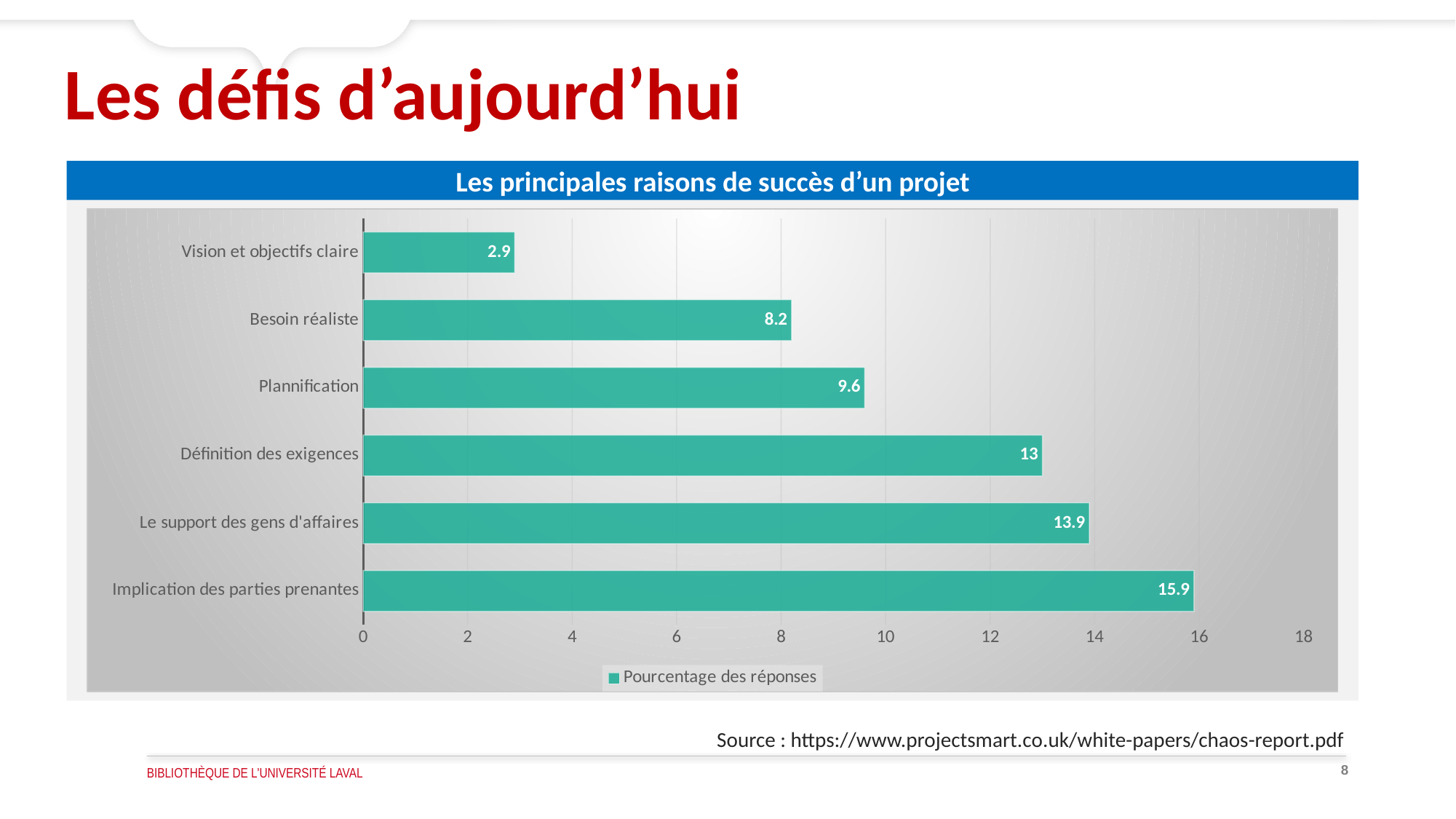
What kind of chart is shown on the slide? bar chart What is the title of the chart? Les principales raisons de succès d'un projet How many series does the legend list? 1 Which category has the highest value? Implication des parties prenantes What is the value for Implication des parties prenantes? 15.9 How many categories are shown in the chart? 6 What is the difference between the values for Le support des gens d'affaires and Définition des exigences? 0.9 Is the value for Définition des exigences greater or less than 12? greater What is the value for Vision et objectifs claire? 2.9 Which category has the lowest value? Vision et objectifs claire What is the value for Plannification? 9.6 Which is larger, the value for Besoin réaliste or the value for Plannification? Plannification